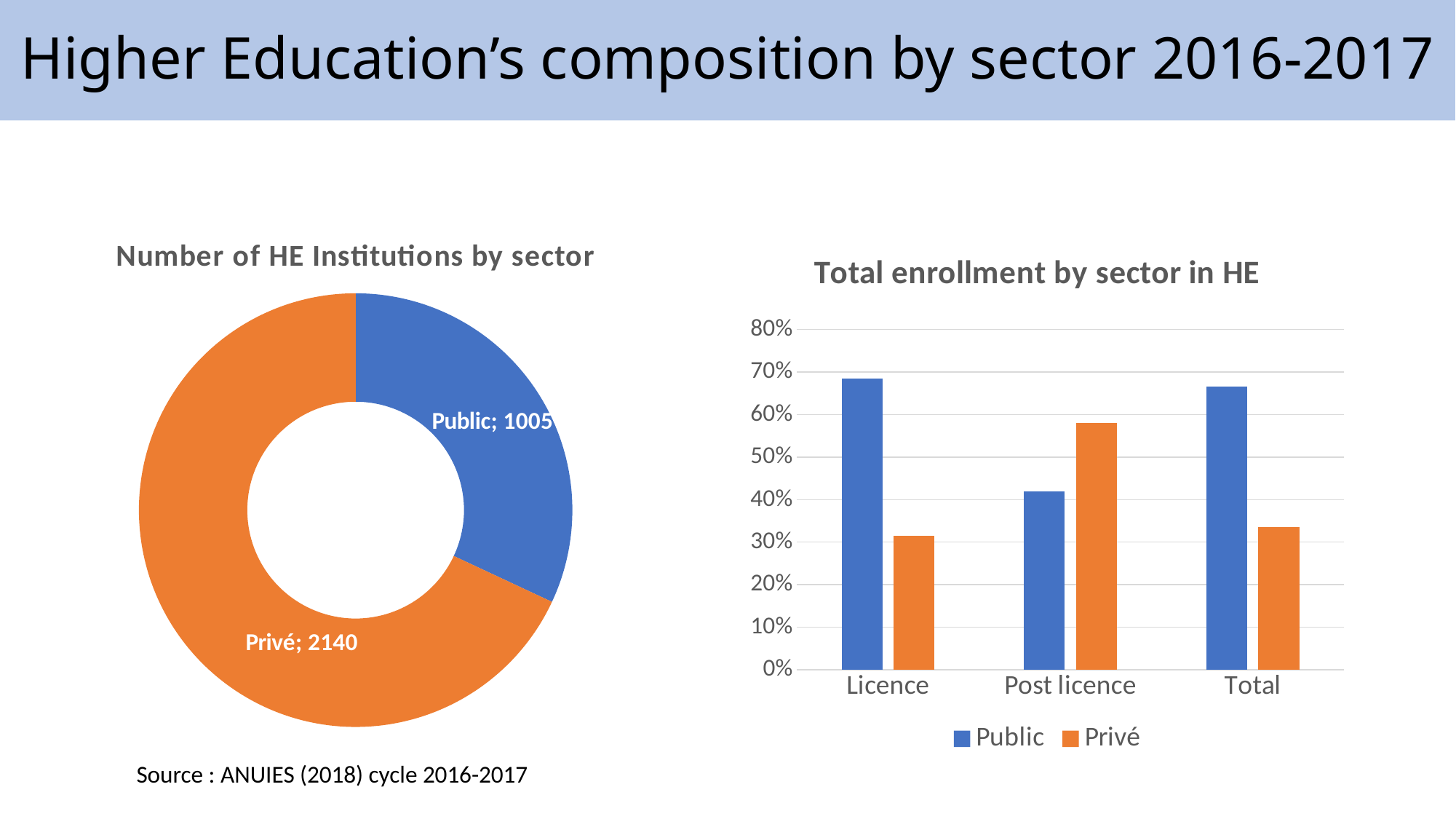
In the 'Number of HE Institutions by sector' chart, how many institutions are in the Privé sector? 2140 In the 'Total enrollment by sector in HE' chart, is the Public value for Licence greater or less than 60%? greater In the 'Number of HE Institutions by sector' chart, what is the total number of institutions across both sectors? 3145 In the 'Number of HE Institutions by sector' chart, what kind of chart is shown? Doughnut (pie) chart In the 'Number of HE Institutions by sector' chart, how many institutions are in the Public sector? 1005 In the 'Total enrollment by sector in HE' chart, how many categories are shown on the x axis? 3 In the 'Total enrollment by sector in HE' chart, what kind of chart is shown? Bar chart In the 'Total enrollment by sector in HE' chart, how many series does the legend list? 2 In the 'Number of HE Institutions by sector' chart, which sector has more institutions? Privé In the 'Total enrollment by sector in HE' chart, for Post licence, which is larger: Public or Privé? Privé In the 'Number of HE Institutions by sector' chart, what is the difference between the Privé and Public counts? 1135 In the 'Total enrollment by sector in HE' chart, is the Privé value for Total greater or less than 40%? less